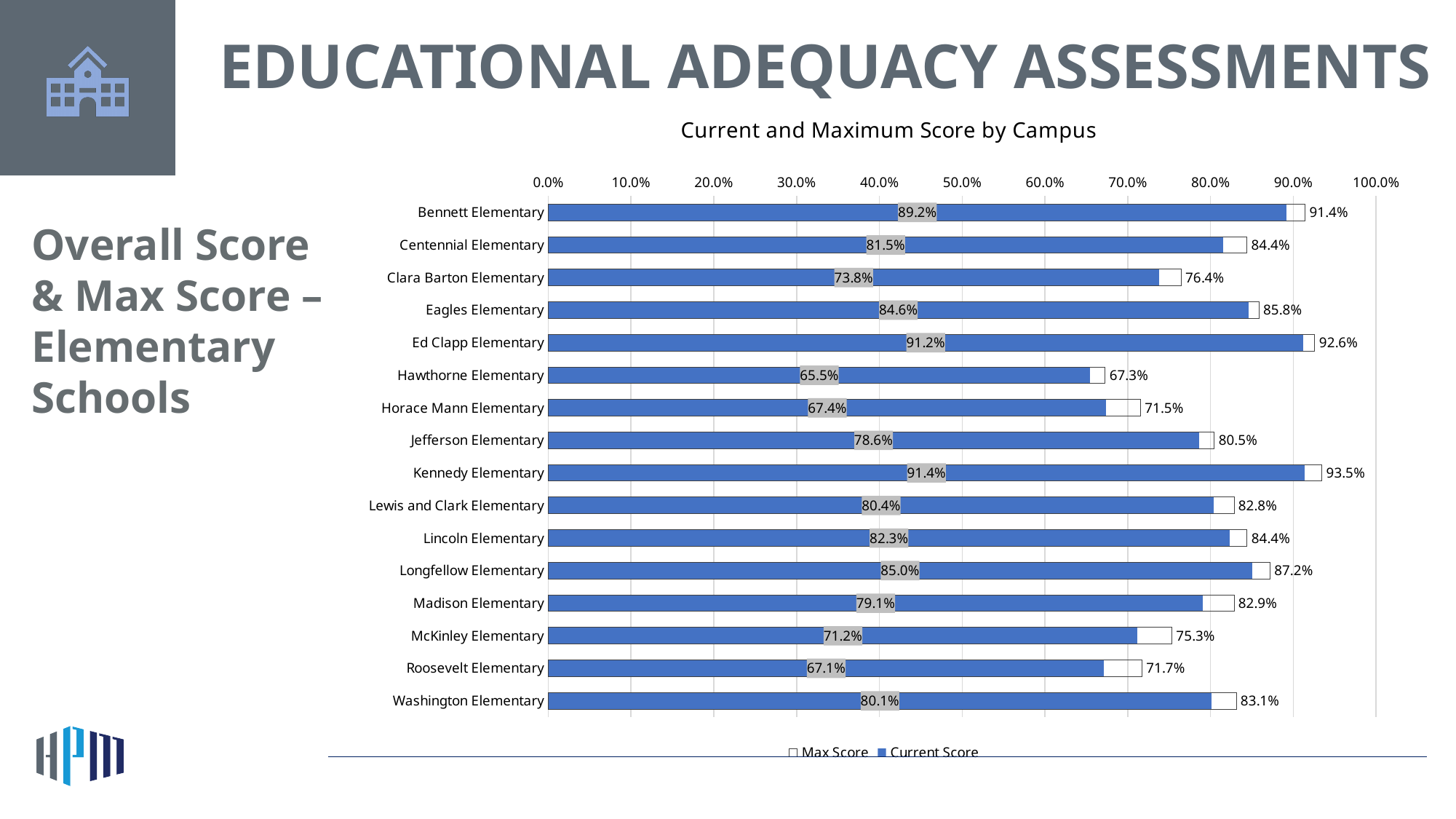
What is the Current Score for Roosevelt Elementary? 67.1% What is the Current Score for Ed Clapp Elementary? 91.2% Which has a higher Current Score, Lincoln Elementary or Centennial Elementary? Lincoln Elementary What type of chart is shown on the slide? Bar chart Which campus has the highest Current Score? Kennedy Elementary How many campuses are shown in the chart? 16 Which campus has the lowest Current Score? Hawthorne Elementary How many series does the legend list? 2 What is the Max Score for Madison Elementary? 82.9% What is the difference between the Max Score and the Current Score for Horace Mann Elementary? 4.1 percentage points Which campus has the lowest Max Score? Hawthorne Elementary What is the difference between the Max Score and the Current Score for Kennedy Elementary? 2.1 percentage points